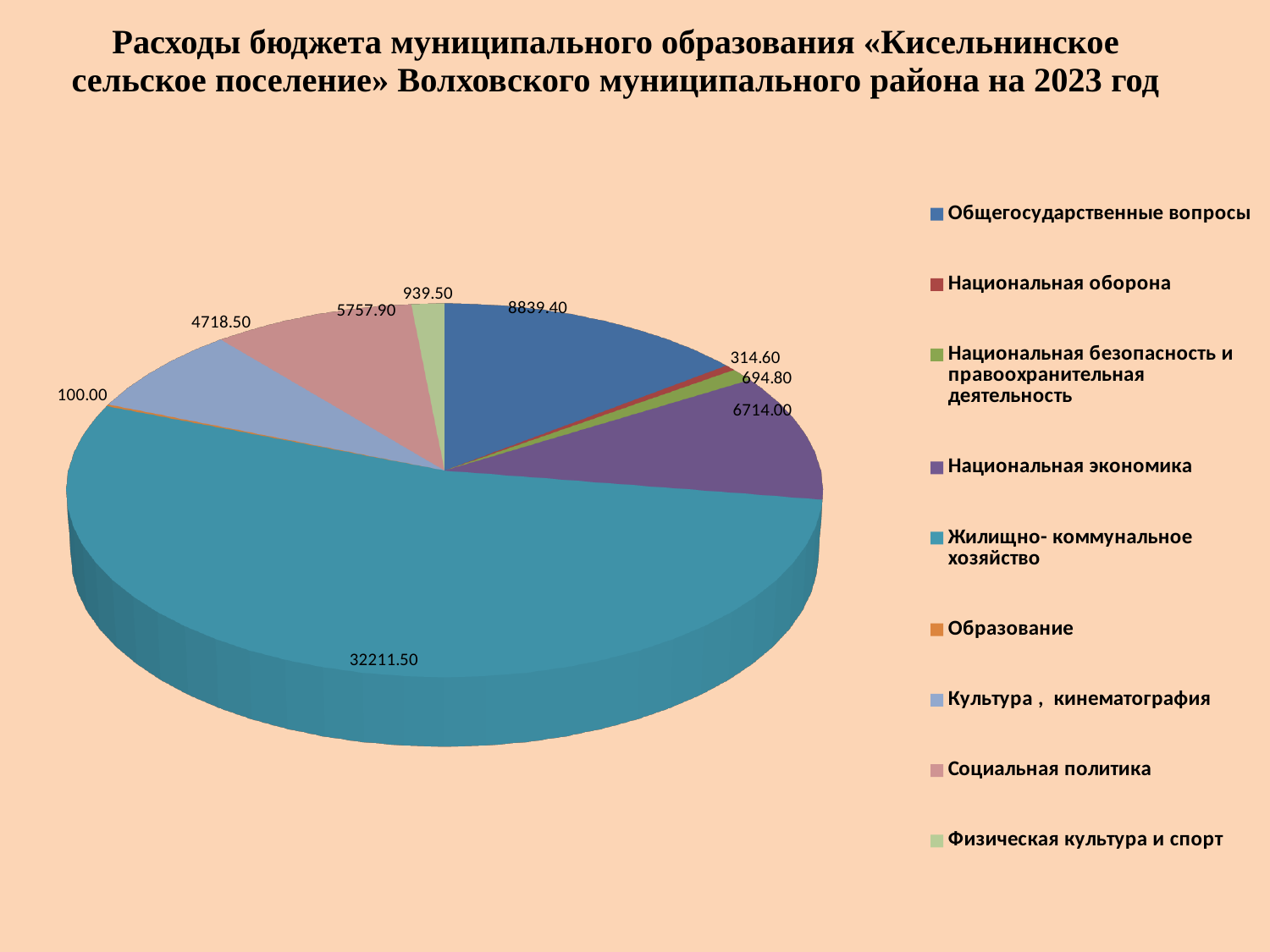
What is the difference between Общегосударственные вопросы and Национальная экономика? 2125.40 Which category has the largest share of the pie? Жилищно-коммунальное хозяйство What is the difference between Физическая культура и спорт and Национальная безопасность и правоохранительная деятельность? 244.70 What is the value for Национальная экономика? 6714.00 Which is larger: Социальная политика or Культура, кинематография? Социальная политика What is the value for Общегосударственные вопросы? 8839.40 What type of chart is shown on the slide? Pie chart Which category has the smallest value? Образование What is the value for Социальная политика? 5757.90 How many categories does the pie chart have? 9 What is the value for Жилищно-коммунальное хозяйство? 32211.50 What is the value for Образование? 100.00